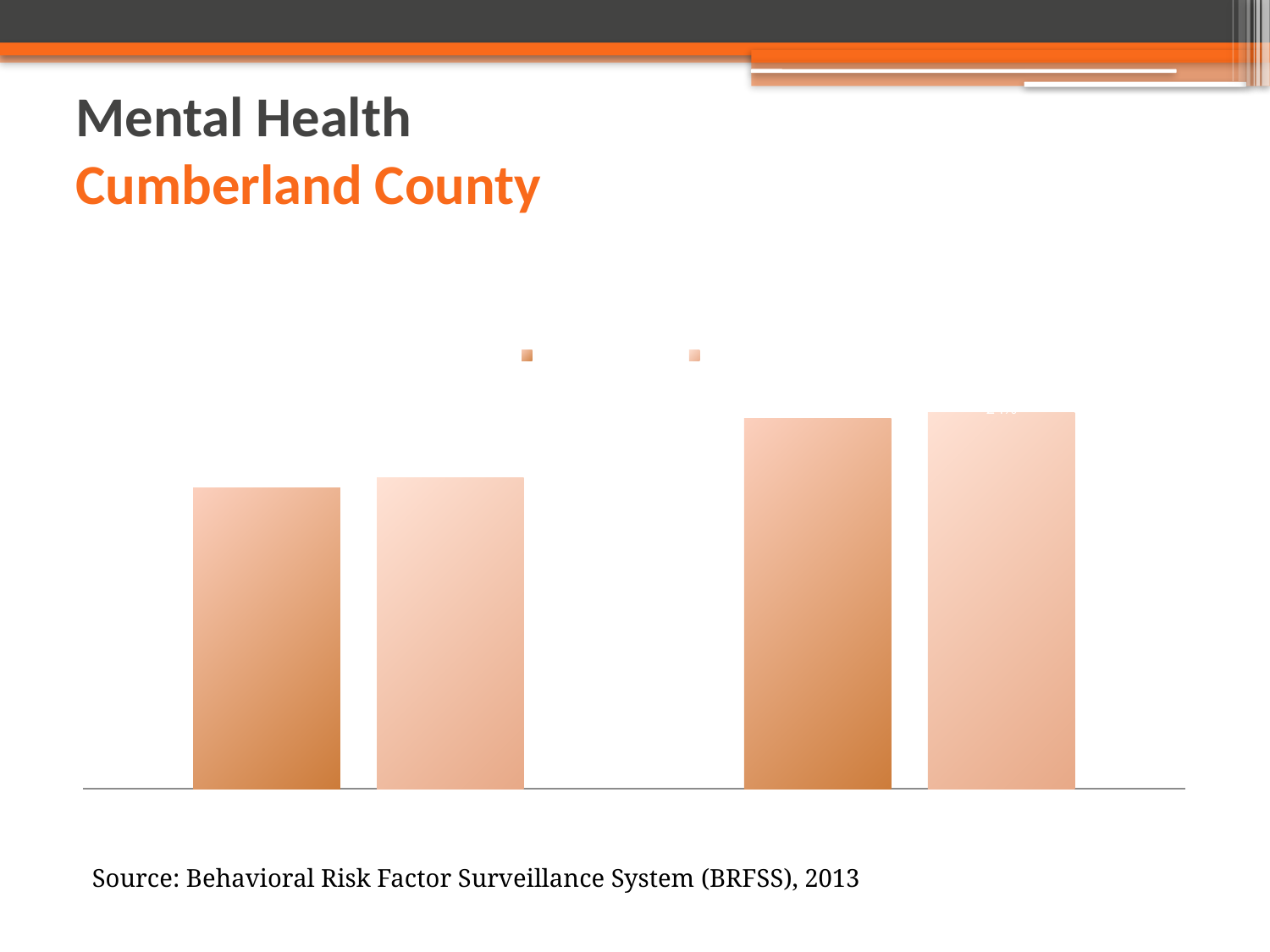
Is the leftmost bar in the chart taller or shorter than the rightmost bar? shorter How many bars are plotted in the chart? 4 What is the title of the slide containing the chart? Mental Health Cumberland County Which group of bars is taller, the left pair or the right pair? the right pair Is the second bar from the left taller or shorter than the third bar from the left? shorter What source is cited below the chart? Behavioral Risk Factor Surveillance System (BRFSS), 2013 What kind of chart is shown on the slide? bar chart How many series does the chart's legend list? 2 Do the bar heights generally rise or fall moving from left to right across the chart? rise